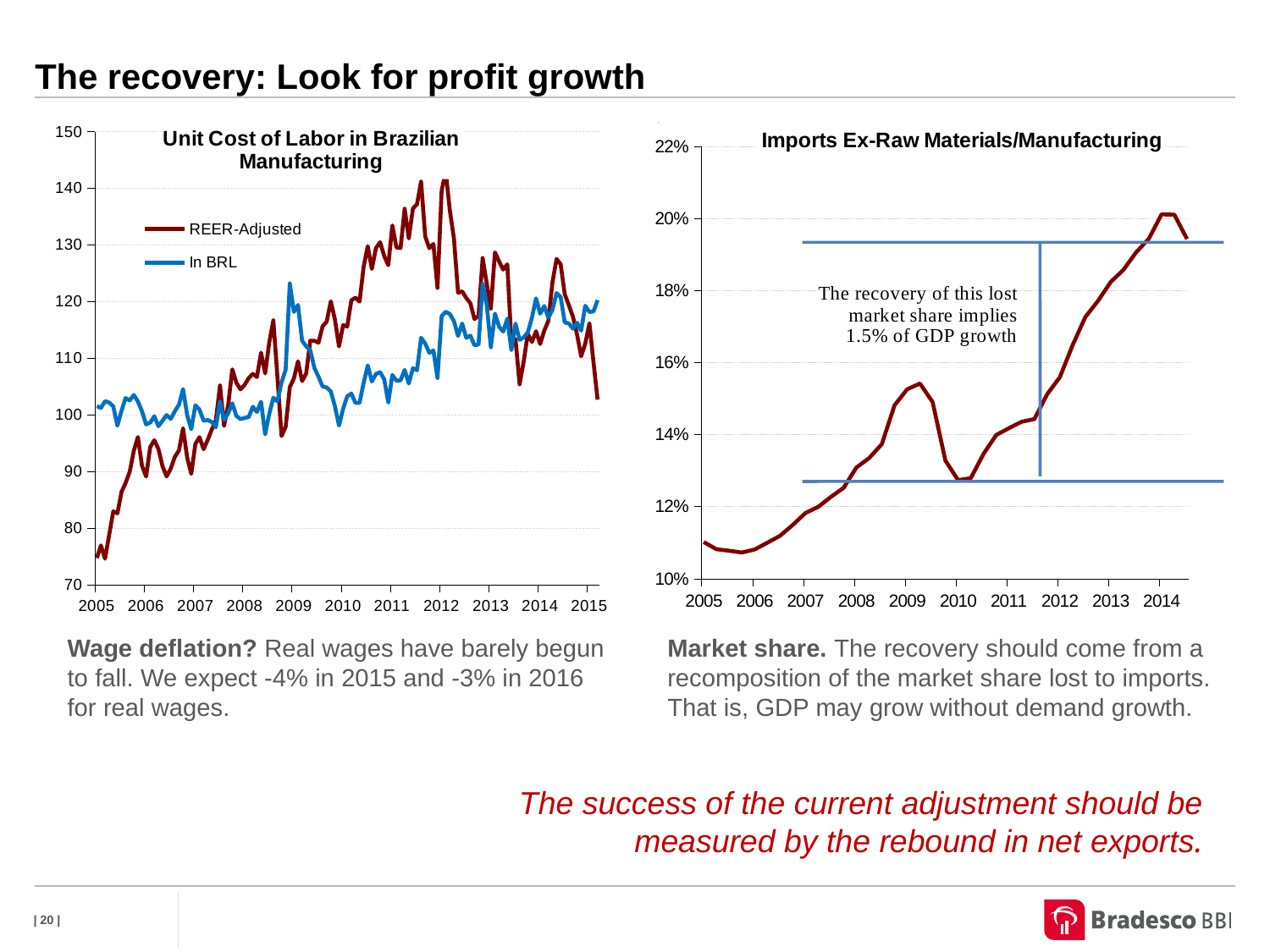
What kind of chart is the 'Unit Cost of Labor in Brazilian Manufacturing' chart? Line chart In the 'Unit Cost of Labor in Brazilian Manufacturing' chart, is the REER-Adjusted value at the start of 2005 greater or less than 80? less According to the annotation on the 'Imports Ex-Raw Materials/Manufacturing' chart, how much GDP growth does the recovery of the lost market share imply? 1.5% In the 'Unit Cost of Labor in Brazilian Manufacturing' chart, does the REER-Adjusted series generally rise or fall from 2005 to 2012? Rise In the 'Unit Cost of Labor in Brazilian Manufacturing' chart, is the In BRL value at the start of 2005 greater or less than 90? greater What kind of chart is the 'Imports Ex-Raw Materials/Manufacturing' chart? Line chart How many series does the legend of the 'Unit Cost of Labor in Brazilian Manufacturing' chart list? 2 In the 'Imports Ex-Raw Materials/Manufacturing' chart, does the line rise or fall from 2010 to 2014? Rise In the 'Imports Ex-Raw Materials/Manufacturing' chart, is the value at the start of 2005 greater or less than 12%? less In the 'Unit Cost of Labor in Brazilian Manufacturing' chart, what are the two series named in the legend? REER-Adjusted and In BRL In the 'Unit Cost of Labor in Brazilian Manufacturing' chart, which series is higher at the start of 2005, REER-Adjusted or In BRL? In BRL